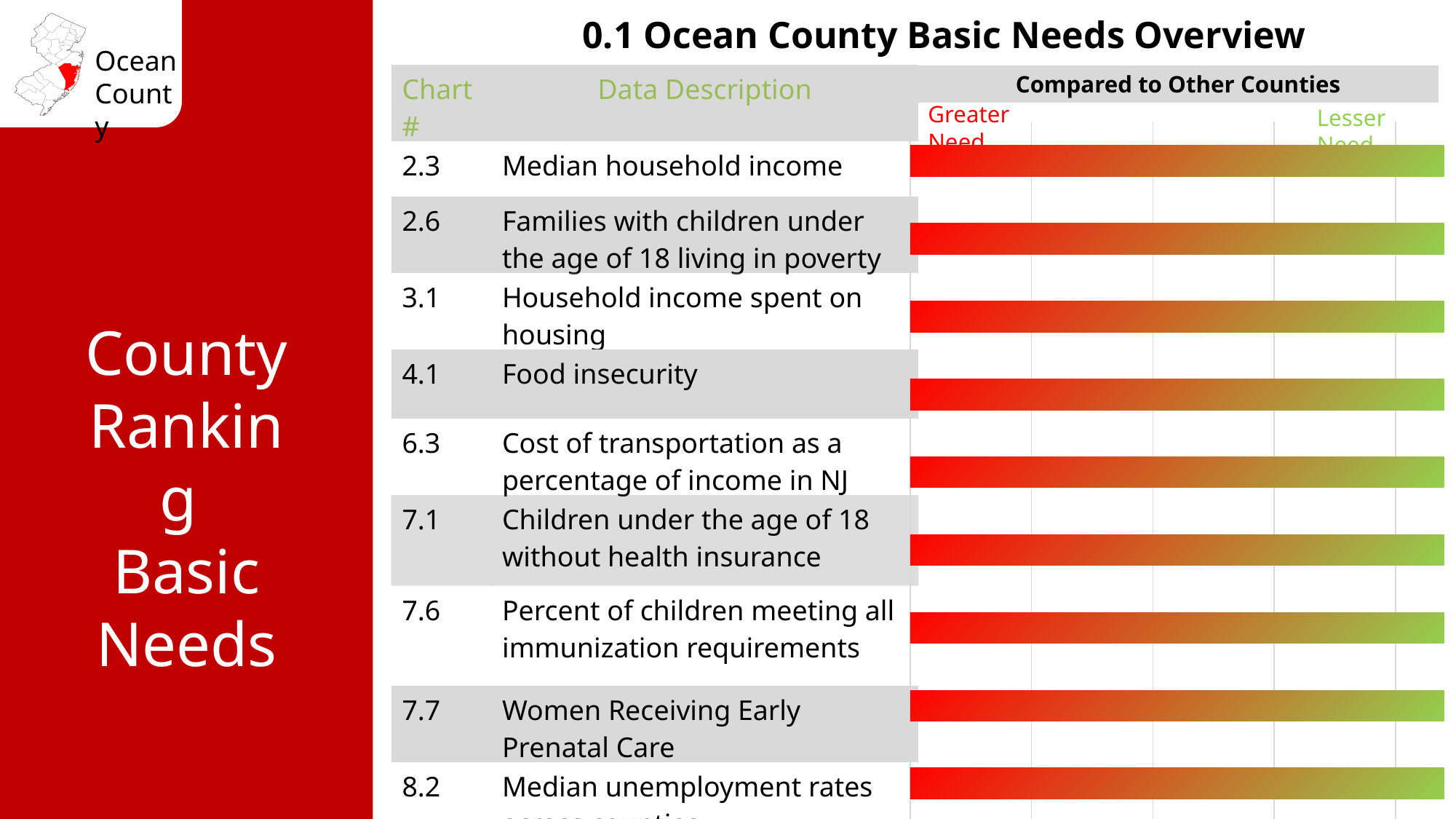
Which data description is listed for chart number 7.7? Women Receiving Early Prenatal Care How many data description rows (categories) are listed in the chart? 9 Which data description is listed for chart number 6.3? Cost of transportation as a percentage of income in NJ Which chart number is listed for 'Median household income'? 2.3 Which data description is listed for chart number 8.2? Median unemployment rates Which chart number is listed for 'Household income spent on housing'? 3.1 What kind of chart is shown on the slide? bar chart What label appears at the left end of the comparison scale in the chart? Greater Need What is the title of the chart on the slide? 0.1 Ocean County Basic Needs Overview Which chart number is listed for 'Food insecurity'? 4.1